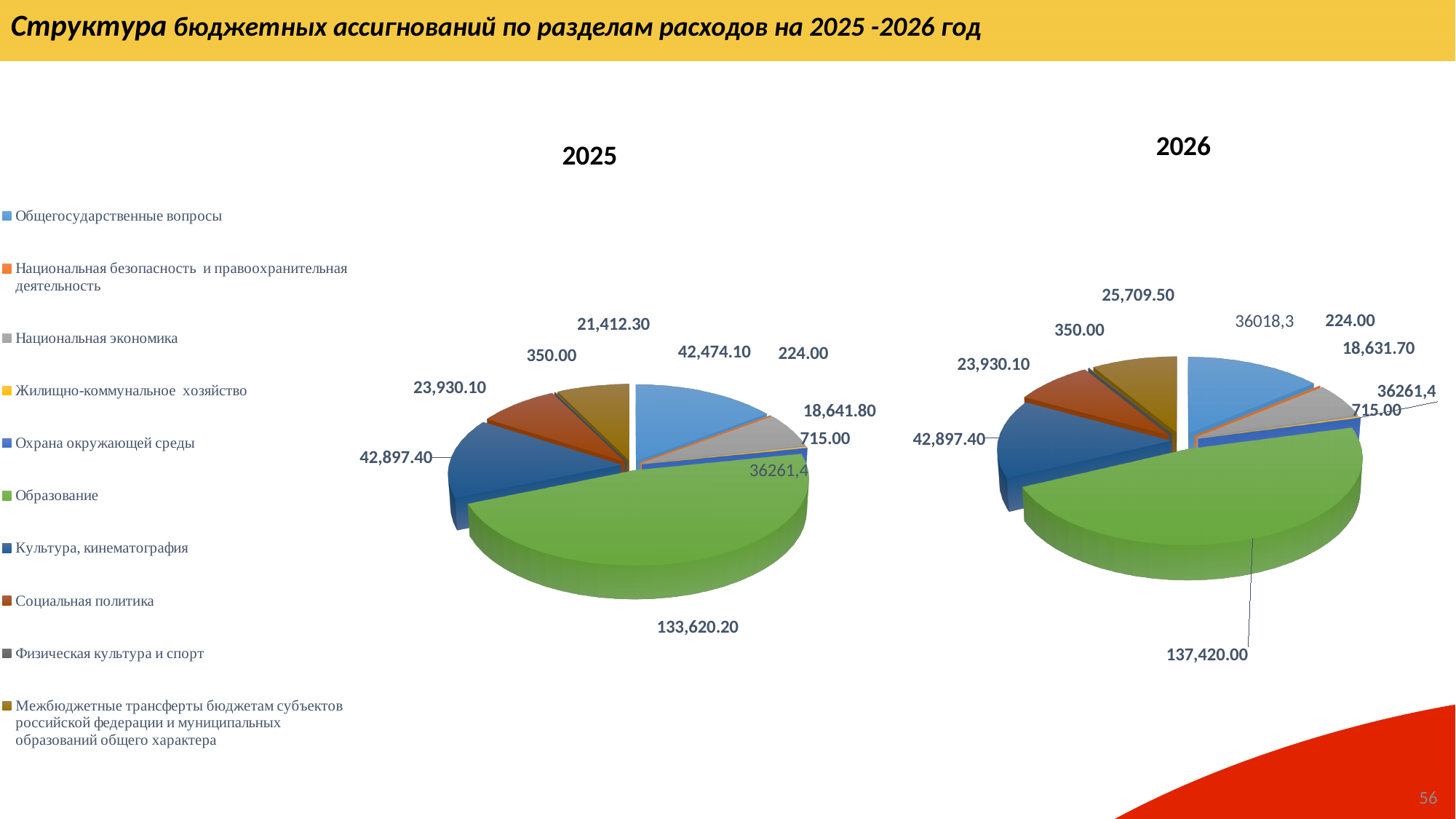
In the 2025 chart, which category has the largest slice? Образование In the 2025 chart, what is the value for Образование? 133,620.20 Is the value for Образование larger in the 2025 chart or the 2026 chart? 2026 What kind of chart is used for the 2025 data on the slide? Pie chart In the 2025 chart, what is the value for Культура, кинематография? 42,897.40 In the 2026 chart, which category has the largest slice? Образование What is the title of the slide? Структура бюджетных ассигнований по разделам расходов на 2025 -2026 год In the 2025 chart, what is the value for Социальная политика? 23,930.10 In the 2026 chart, what is the value for Образование? 137,420.00 By how much does the value for Образование in the 2026 chart exceed the value in the 2025 chart? 3,799.80 In the 2026 chart, what is the value for Межбюджетные трансферты бюджетам субъектов российской федерации и муниципальных образований общего характера? 25,709.50 How many categories does the legend list? 10